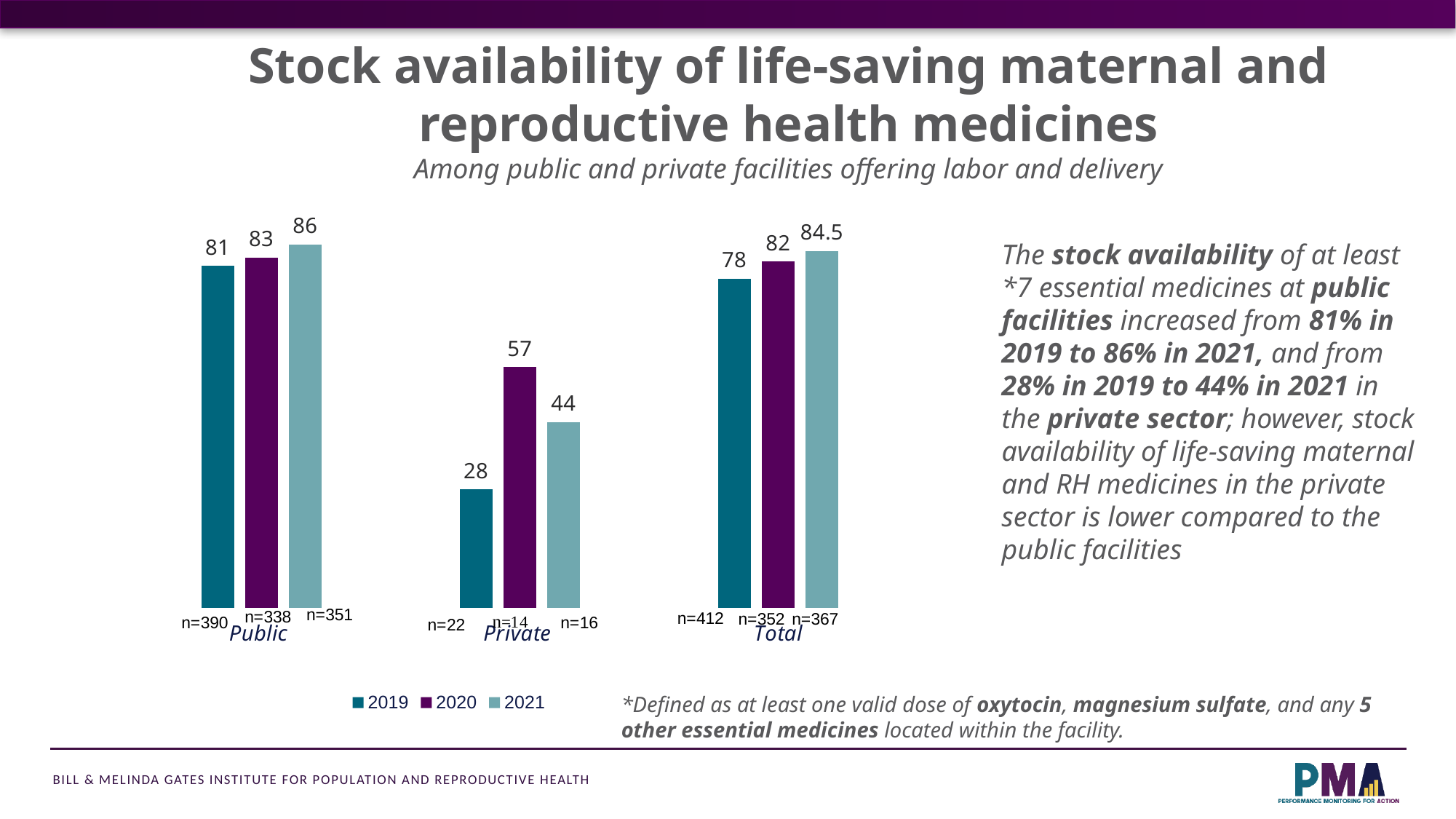
Which is larger, the Private value in 2020 or the Private value in 2021? Private in 2020 What is the value for Public in 2021? 86 How many categories are shown on the x axis? 3 Which category has the highest value in 2021? Public What is the difference between the Public and Private values in 2021? 42 Which category has the lowest value in 2019? Private What is the value for Total in 2021? 84.5 What kind of chart is shown on the slide? Bar chart What is the value for Private in 2020? 57 What is the difference between the 2019 and 2021 values for Total? 6.5 What is the value for Private in 2019? 28 How many series does the legend list? 3